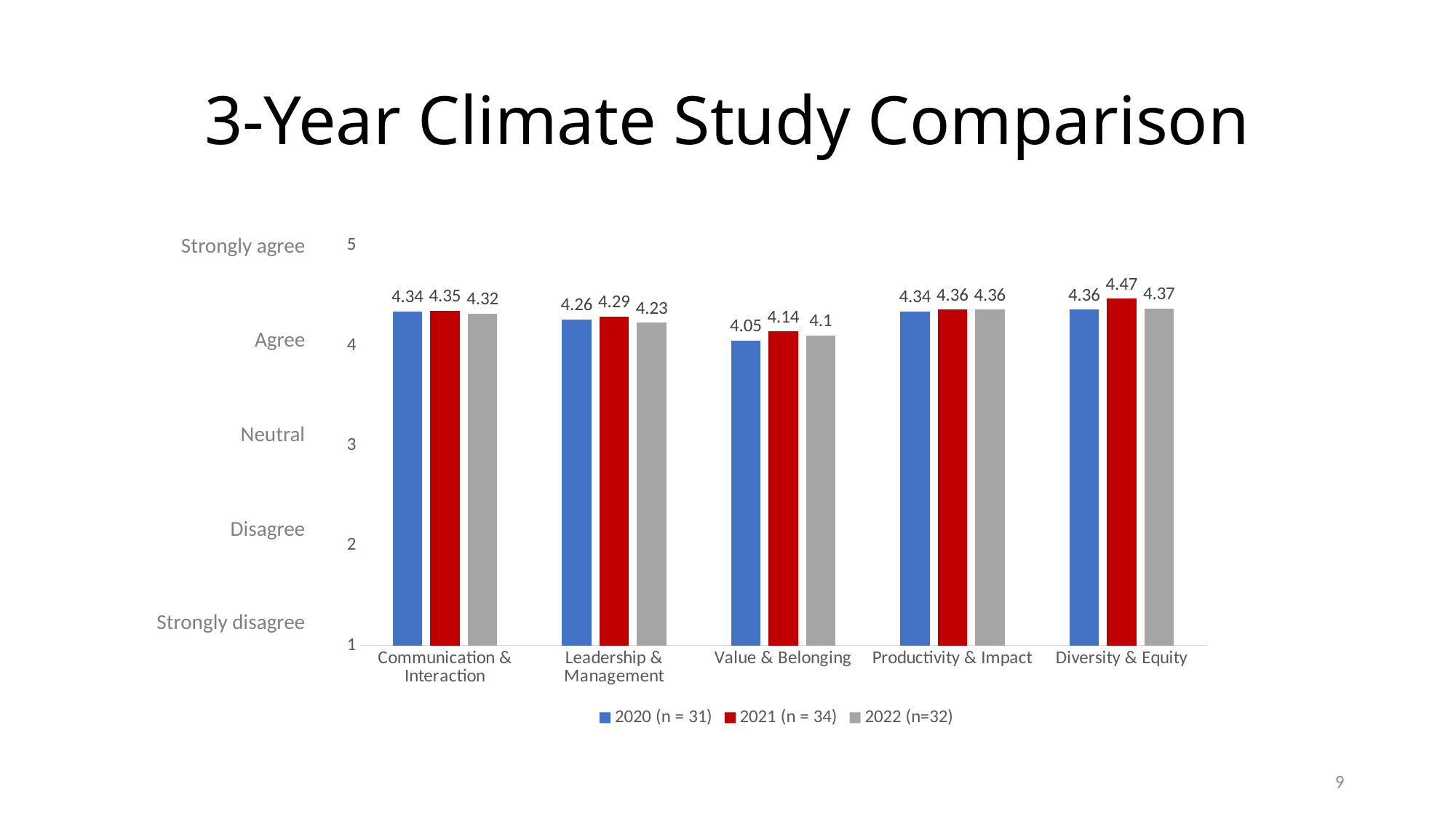
How many series does the legend list? 3 How many categories are shown on the x axis? 5 What is the value for Value & Belonging in the 2020 (n = 31) series? 4.05 What is the title of the slide? 3-Year Climate Study Comparison What kind of chart is shown on the slide? bar chart What is the difference between the 2021 (n = 34) and 2020 (n = 31) values for Value & Belonging? 0.09 Is the value for Value & Belonging in 2020 (n = 31) greater or less than 4? greater Which category has the highest value in the 2022 (n=32) series? Diversity & Equity Which is larger for Leadership & Management: the 2020 (n = 31) value or the 2022 (n=32) value? 2020 (n = 31) Which category has the lowest value in the 2021 (n = 34) series? Value & Belonging What is the value for Diversity & Equity in the 2021 (n = 34) series? 4.47 What is the value for Leadership & Management in the 2022 (n=32) series? 4.23